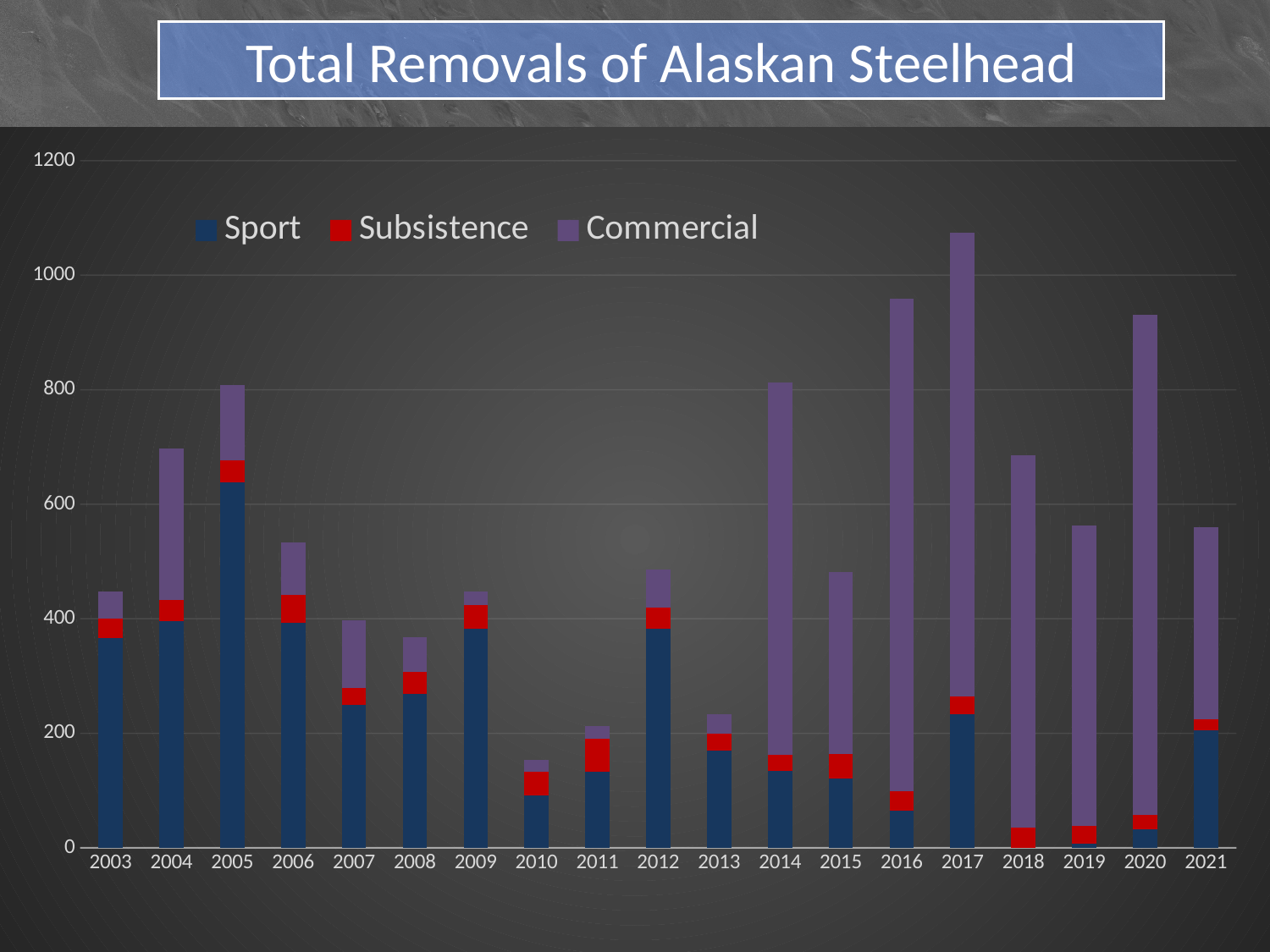
What is the title of the chart? Total Removals of Alaskan Steelhead How many series does the legend list? 3 Is the total for 2016 greater or less than 1000? less Is the total for 2018 greater or less than 600? greater Which year has the larger total removals, 2005 or 2004? 2005 Which year has the largest Sport removals? 2005 Which year has the highest total removals? 2017 Is the total for 2010 greater or less than 200? less Which year has the lowest total removals? 2010 How many years are shown along the x axis? 19 What kind of chart is shown on the slide? Stacked bar chart